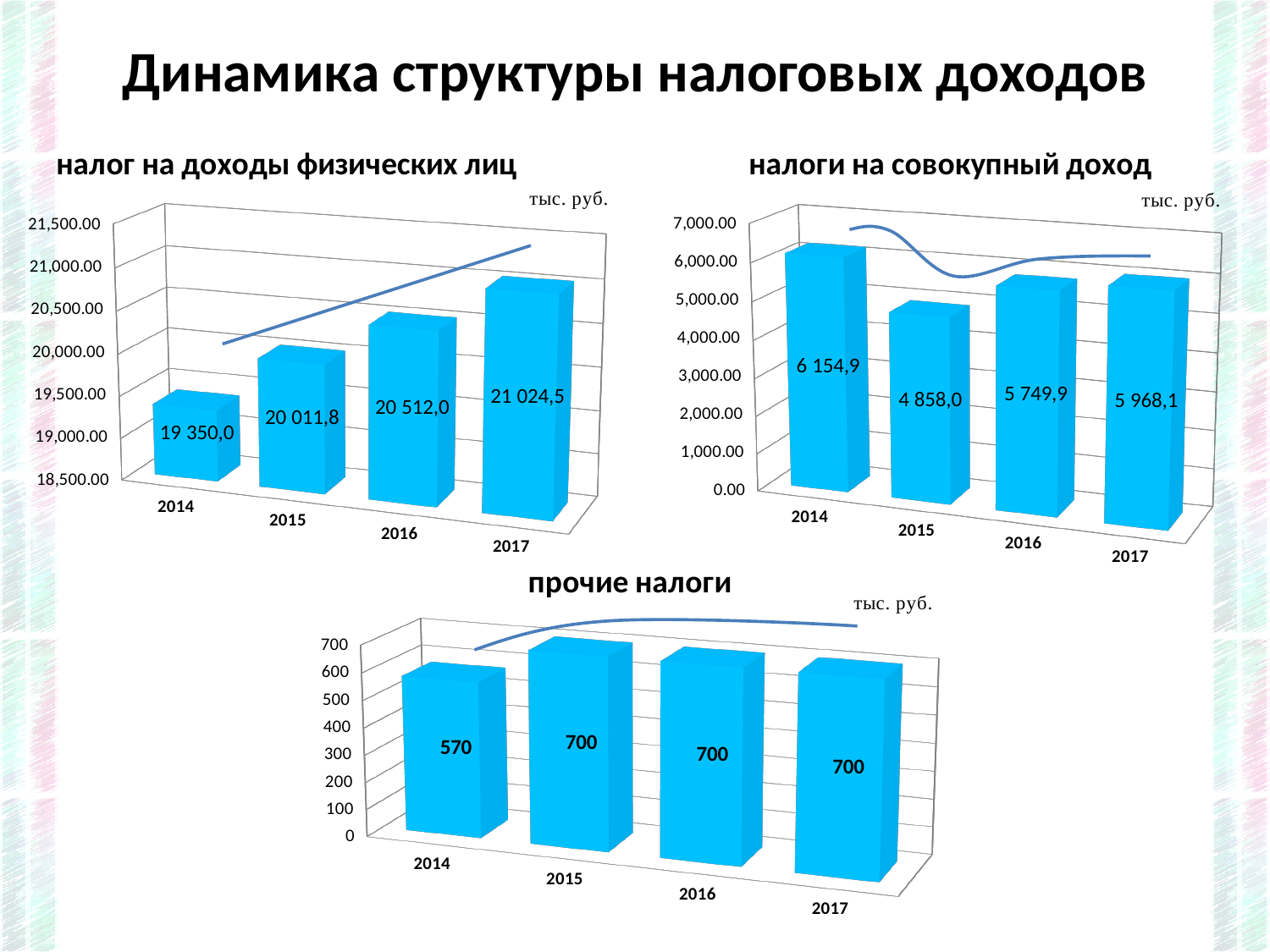
In the chart titled "налоги на совокупный доход", what is the value for 2016? 5 749,9 In the chart titled "налоги на совокупный доход", which year has the lowest value? 2015 In the chart titled "налоги на совокупный доход", which is larger, the value for 2014 or the value for 2017? 2014 In the chart titled "налог на доходы физических лиц", which year has the highest value? 2017 In the chart titled "налог на доходы физических лиц", what is the value for 2014? 19 350,0 In the chart titled "прочие налоги", what is the value for 2014? 570 In the chart titled "налог на доходы физических лиц", what is the difference between the 2017 and 2014 values? 1 674,5 In the chart titled "прочие налоги", what is the difference between the 2015 and 2014 values? 130 In the chart titled "налог на доходы физических лиц", do the values rise or fall from 2014 to 2017? rise In the chart titled "налоги на совокупный доход", what is the difference between the 2014 and 2015 values? 1 296,9 How many years are shown on the x axis of the chart titled "прочие налоги"? 4 What kind of chart is the chart titled "налог на доходы физических лиц"? bar chart